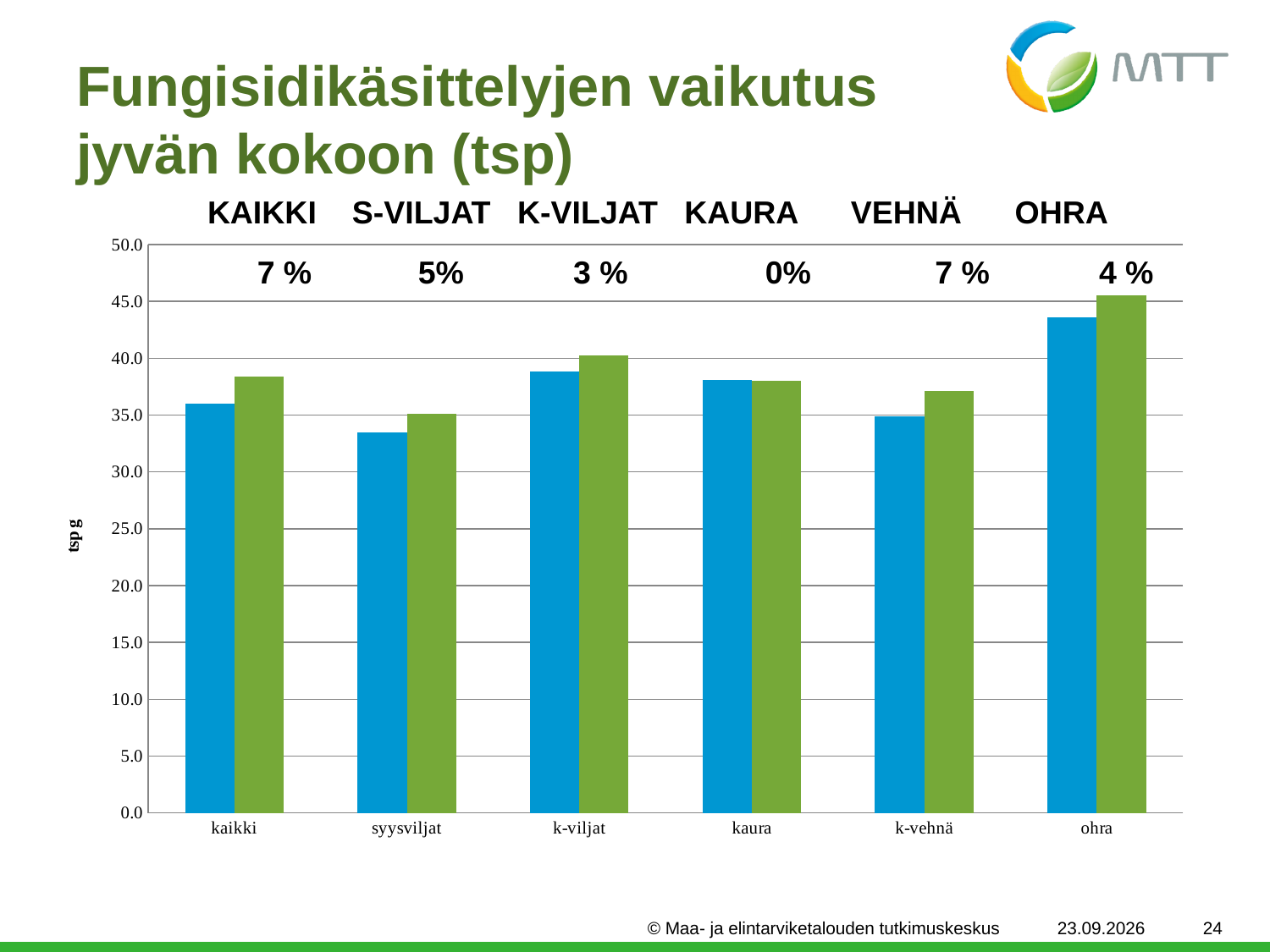
How many bars are plotted for each category in the chart? 2 Which category has the shortest blue bar in the chart? syysviljat What percentage is printed above the chart for KAURA? 0% How many categories are shown on the x axis of the chart? 6 Is the green bar for ohra greater or less than 45.0? greater Which category has the tallest green bar in the chart? ohra What is the label on the y axis of the chart? tsp g Is the blue bar for syysviljat greater or less than 35.0? less What kind of chart is shown on the slide? bar chart Which is taller for k-vehnä, the blue bar or the green bar? the green bar